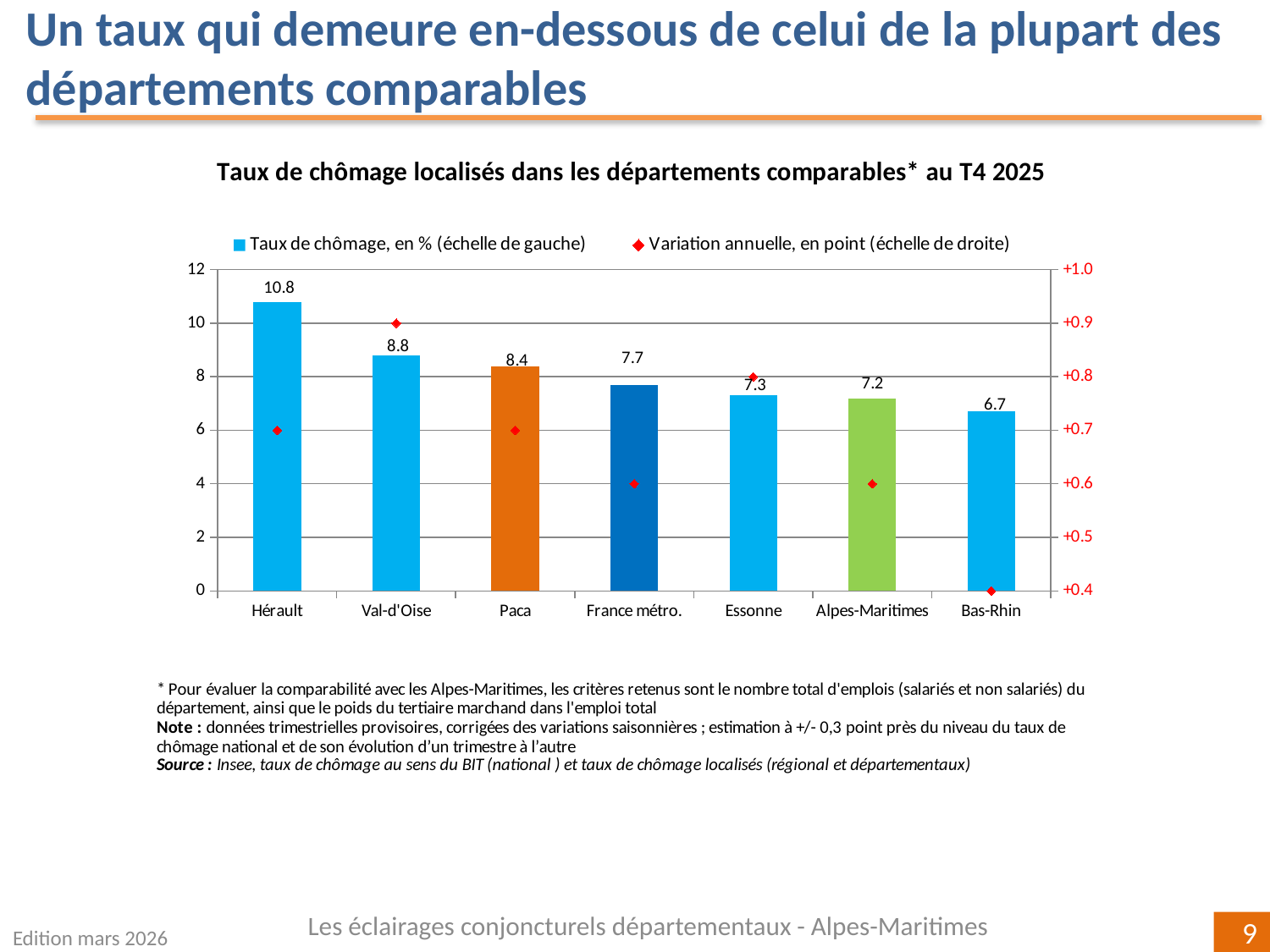
What is the unemployment rate shown for Alpes-Maritimes? 7.2 Which has a higher unemployment rate, Val-d'Oise or Paca? Val-d'Oise What is the unemployment rate (Taux de chômage) shown for Hérault? 10.8 What is the annual variation shown for Bas-Rhin on the right axis? +0.4 How many series does the legend list? 2 What is the annual variation (Variation annuelle) shown for Val-d'Oise on the right axis? +0.9 How many categories are shown on the x axis? 7 What is the unemployment rate shown for France métro.? 7.7 Is the unemployment rate for Essonne greater or less than 8? less Which category has the lowest unemployment rate? Bas-Rhin Which category has the highest unemployment rate? Hérault What is the difference between the unemployment rates of Hérault and Bas-Rhin? 4.1